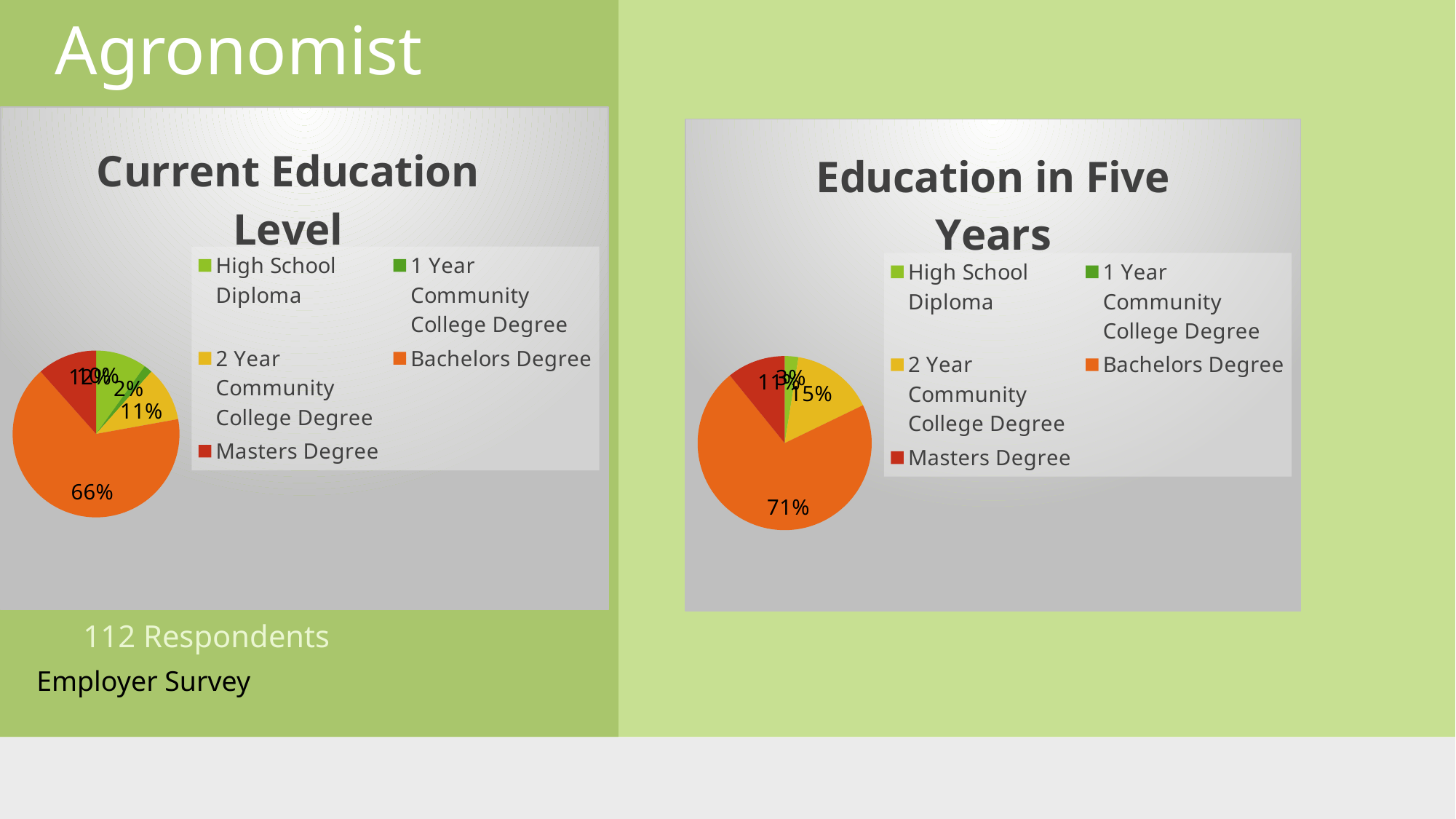
What type of chart is used for Current Education Level? Pie chart In the Education in Five Years chart, what percentage is shown for 2 Year Community College Degree? 15% How many education levels does the legend of the Education in Five Years chart list? 5 In the Current Education Level chart, what is the difference between the Bachelors Degree share and the 2 Year Community College Degree share? 55 percentage points In the Current Education Level chart, which education level has the largest share? Bachelors Degree In the Education in Five Years chart, what share is shown for Bachelors Degree? 71% In the Current Education Level chart, what share of respondents have a Bachelors Degree? 66% In the Education in Five Years chart, which education level has the smallest slice? 1 Year Community College Degree In the Current Education Level chart, what percentage is shown for 1 Year Community College Degree? 2% In the Current Education Level chart, what percentage is shown for 2 Year Community College Degree? 11% Is the 2 Year Community College Degree share larger in the Current Education Level chart or in the Education in Five Years chart? Education in Five Years How many percentage points higher is the Bachelors Degree share in the Education in Five Years chart than in the Current Education Level chart? 5